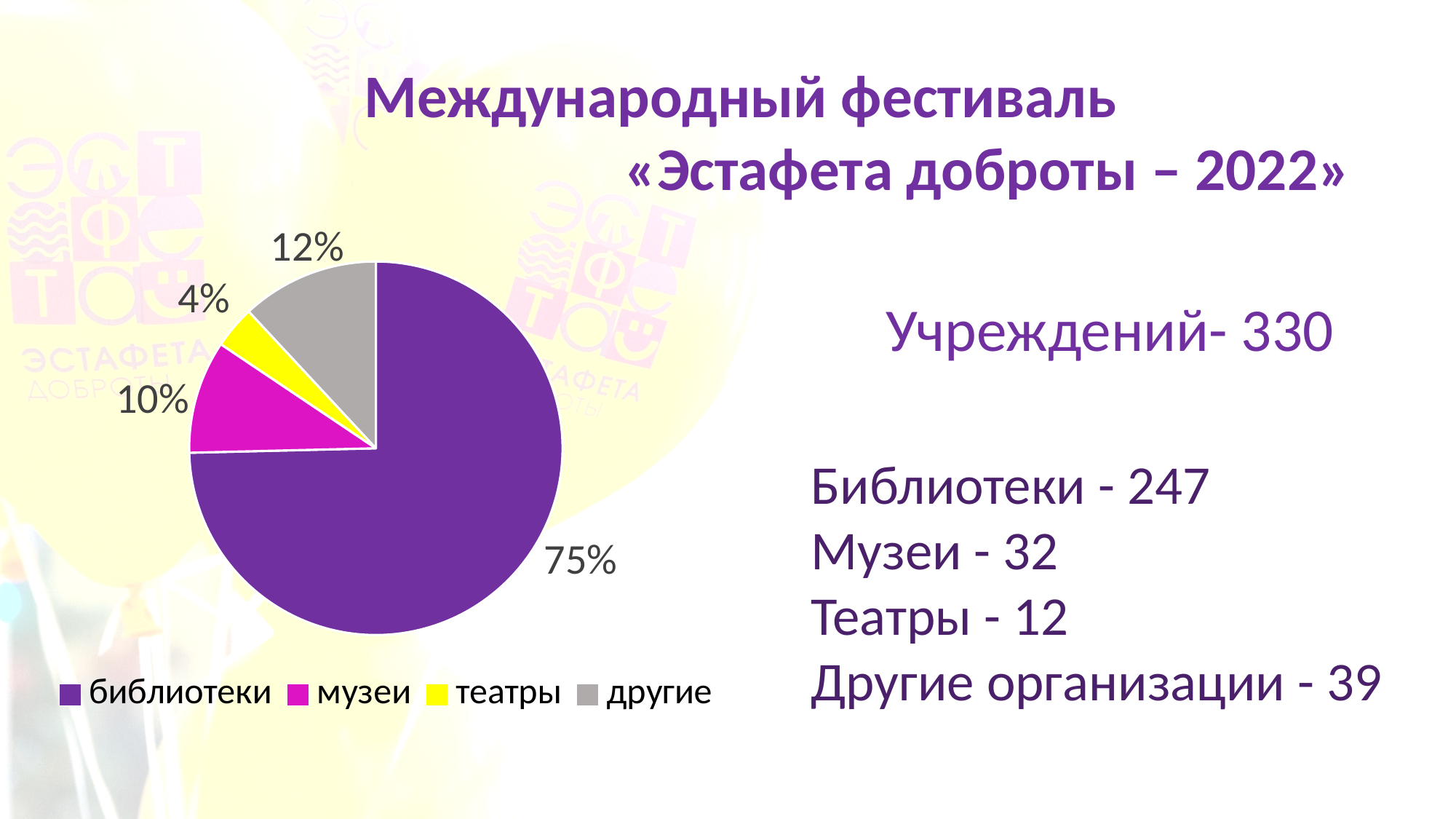
What is the difference in percentage points between the библиотеки slice and the другие slice? 63% What colour is the музеи slice in the pie chart? magenta What share of the pie does the театры slice have? 4% What kind of chart is shown on the slide? pie chart What share of the pie does the другие slice have? 12% What share of the pie does the библиотеки slice have? 75% How many slices does the pie chart have? 4 Which category has the smallest slice of the pie? театры How many entries does the legend list? 4 Which category has the largest slice of the pie? библиотеки Which slice is larger, музеи or другие? другие